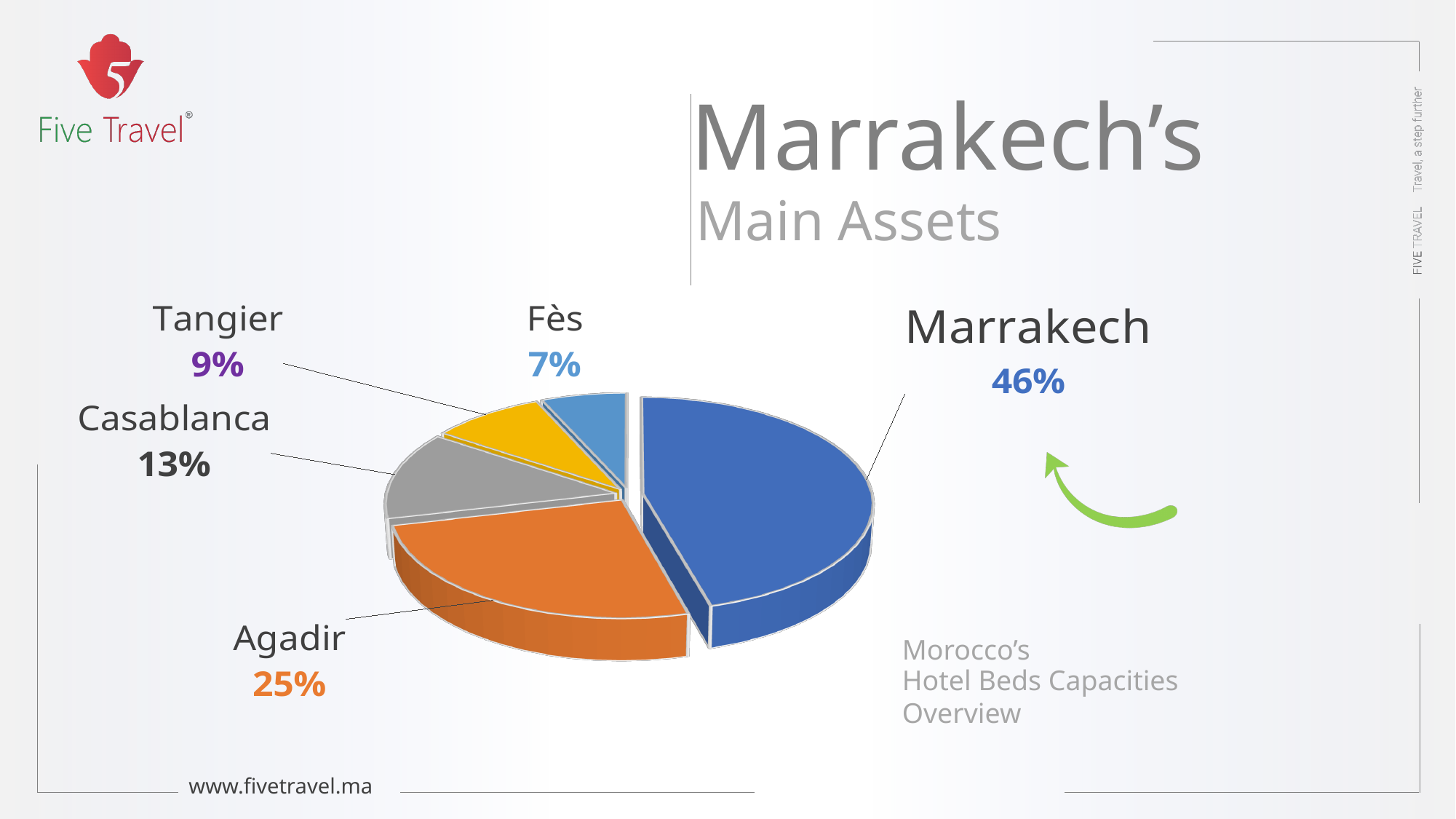
What type of chart is shown on the slide? Pie chart Which city has the largest slice of the pie chart? Marrakech What percentage is shown for Casablanca in the pie chart? 13% What colour is the Agadir slice of the pie chart? Orange What percentage is shown for Agadir in the pie chart? 25% What percentage is shown for Tangier in the pie chart? 9% Which city has the smallest slice of the pie chart? Fès Which has a larger share, Casablanca or Tangier? Casablanca What percentage is shown for Fès in the pie chart? 7% What share of Morocco's hotel bed capacity does Marrakech hold according to the pie chart? 46% What is the difference in percentage points between Marrakech and Agadir? 21 How many cities are shown in the pie chart? 5